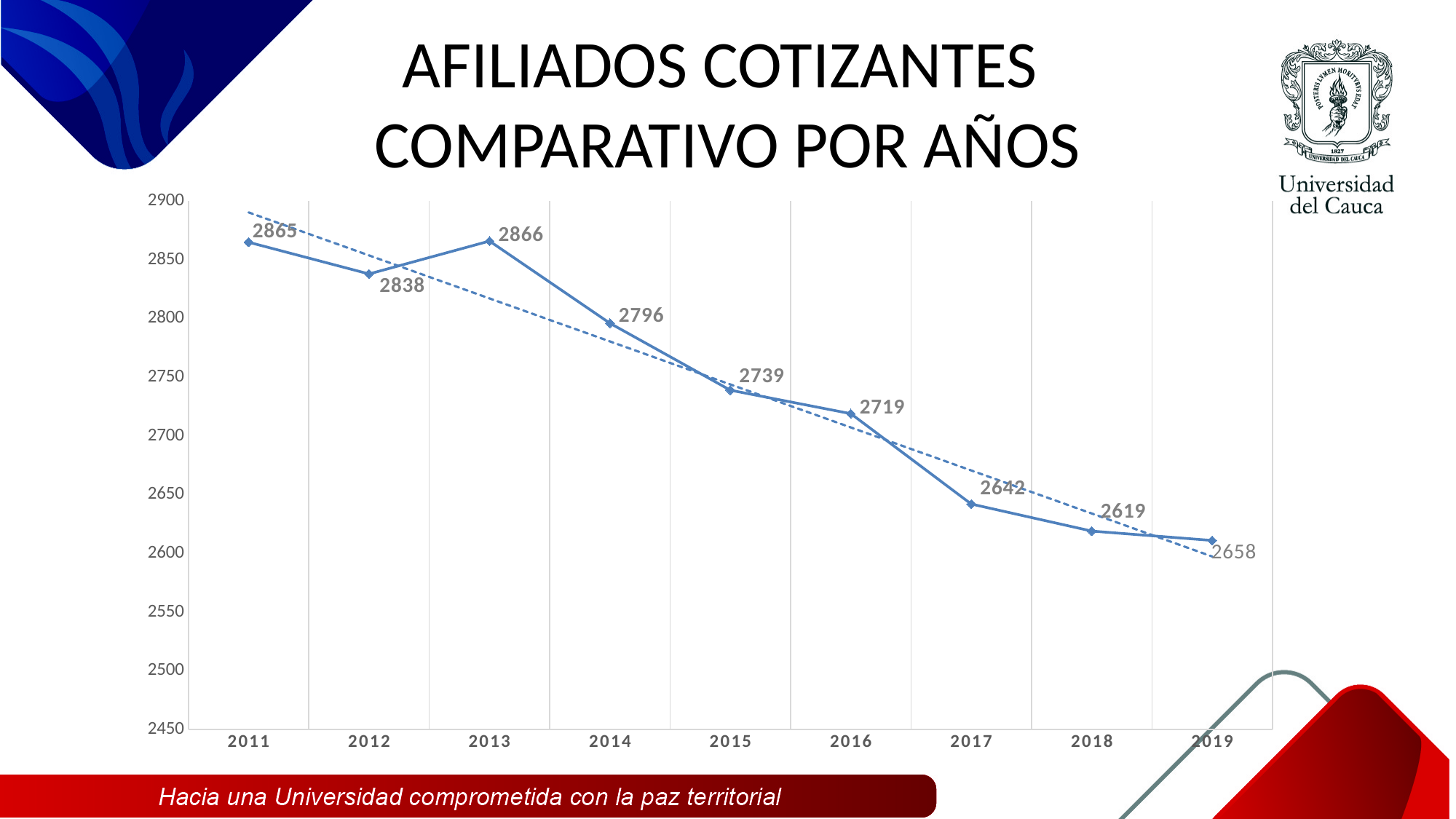
What is the difference between the values for 2011 and 2018? 246 What is the difference between the values for 2014 and 2015? 57 What is the title of the slide containing the chart? AFILIADOS COTIZANTES COMPARATIVO POR AÑOS What is the value for 2017? 2642 What is the value for 2012? 2838 Which year has the larger value, 2013 or 2016? 2013 Is the value for 2016 greater or less than 2700? greater What kind of chart is shown on the slide? line chart What is the value for 2014? 2796 Do the values generally rise or fall from 2011 to 2019? fall How many years are plotted on the x axis? 9 What is the value for 2015? 2739